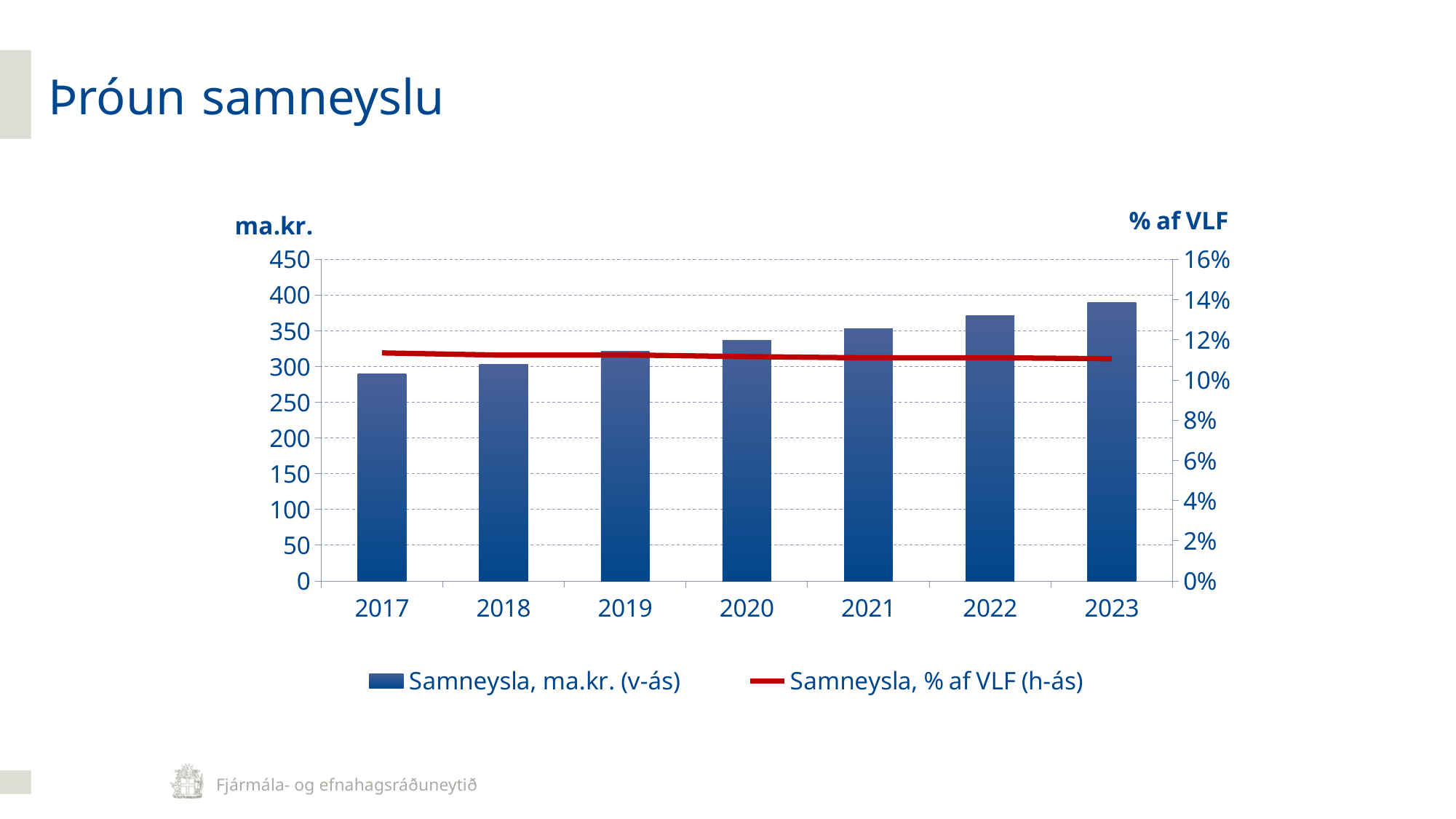
Is the Samneysla, ma.kr. bar for 2017 greater or less than 300? less What is the title of the chart on the slide? Þróun samneyslu Is the Samneysla, % af VLF value for 2017 greater or less than 10%? greater Do the Samneysla, ma.kr. bars rise or fall from 2017 to 2023? rise How many series does the chart's legend list? 2 Which year has the lowest bar for Samneysla, ma.kr.? 2017 Which is larger, the Samneysla, ma.kr. bar for 2022 or for 2018? 2022 How many years are shown on the x axis of the chart? 7 Is the Samneysla, ma.kr. bar for 2019 greater or less than 300? greater What unit label is shown above the left axis of the chart? ma.kr. Which year has the highest bar for Samneysla, ma.kr.? 2023